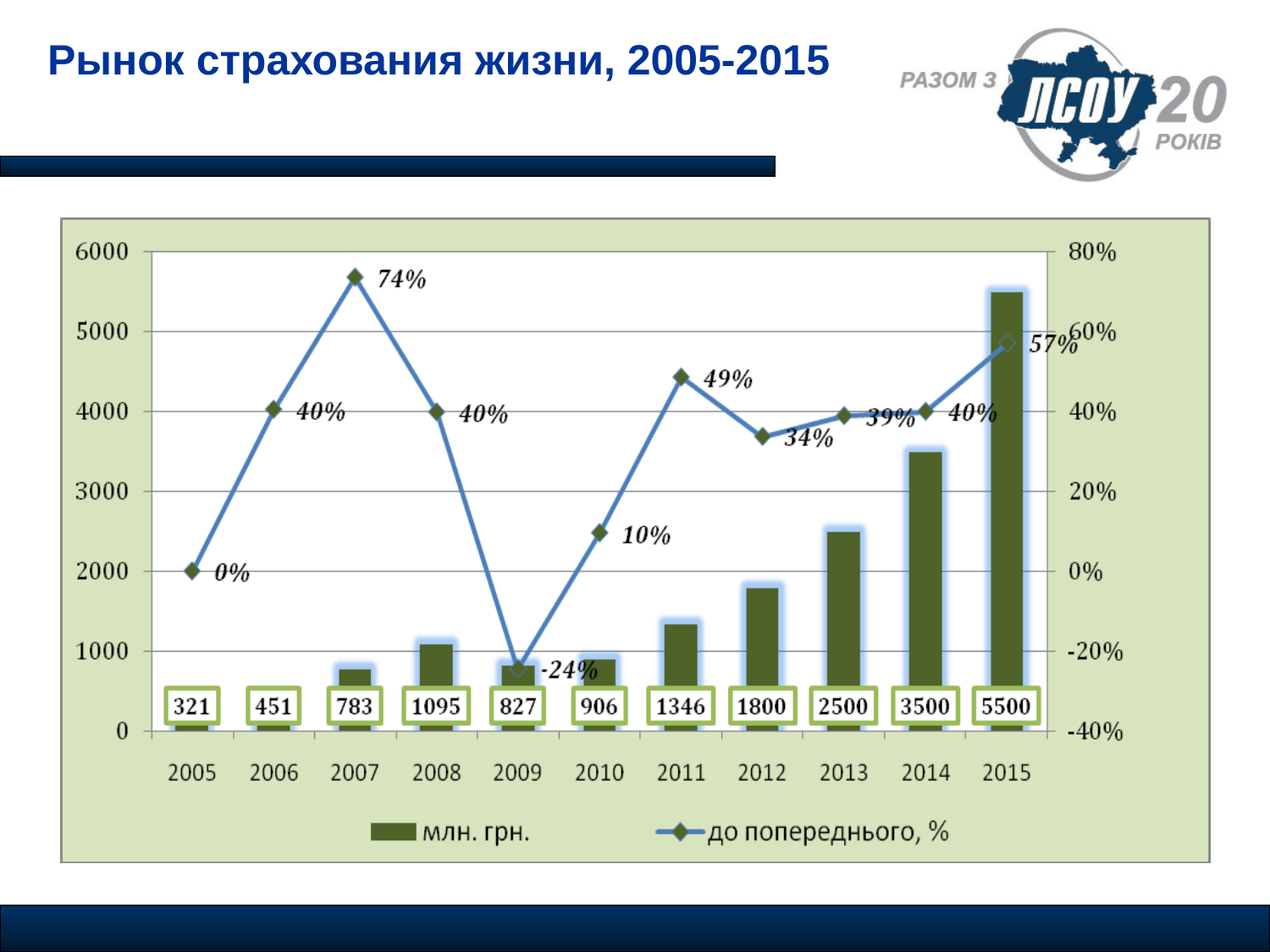
Which year has the lowest 'до попереднього, %' value? 2009 Which year has the highest value in млн. грн.? 2015 What is the value in млн. грн. for 2008? 1095 What kinds of chart are combined on this slide? Bar chart and line chart How many series does the legend list? 2 What is the title of the slide? Рынок страхования жизни, 2005-2015 How many years are shown on the x axis? 11 What is the 'до попереднього, %' value for 2012? 34% Which year has the larger value in млн. грн., 2008 or 2009? 2008 What is the 'до попереднього, %' value for 2007? 74% What is the difference in млн. грн. between 2015 and 2014? 2000 Do the млн. грн. values rise or fall from 2009 to 2015? Rise